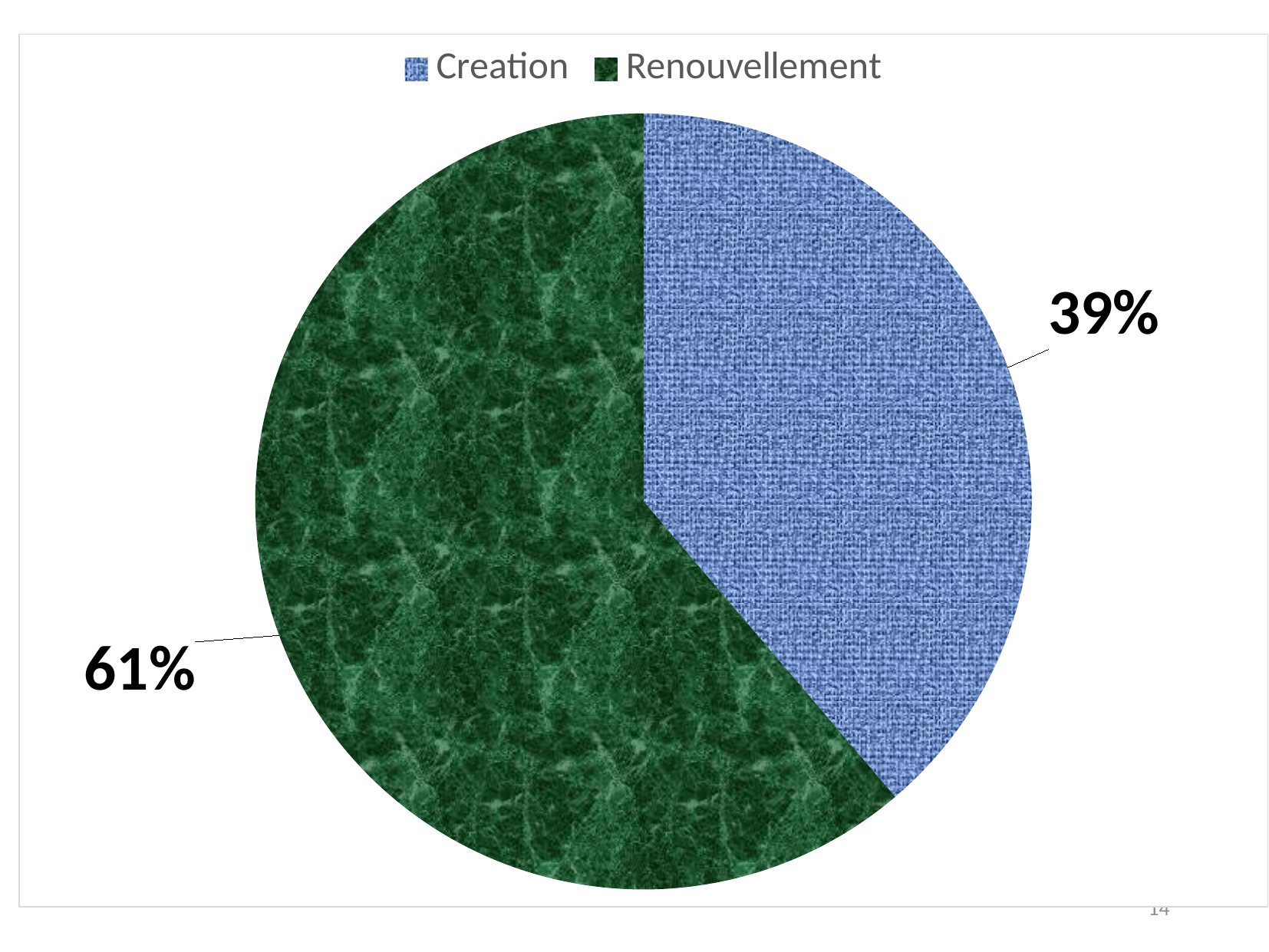
What kind of chart is shown on the slide? pie chart How many slices does the pie chart have? 2 Which category has the smallest slice of the pie? Creation What share of the pie does Creation represent? 39% Which category is shown in blue in the pie chart? Creation How many entries does the legend list? 2 Which category has the largest slice of the pie? Renouvellement What is the difference in percentage points between the Renouvellement share and the Creation share? 22 Which category is shown in green in the pie chart? Renouvellement What share of the pie does Renouvellement represent? 61% Which is larger, the share for Creation or the share for Renouvellement? Renouvellement